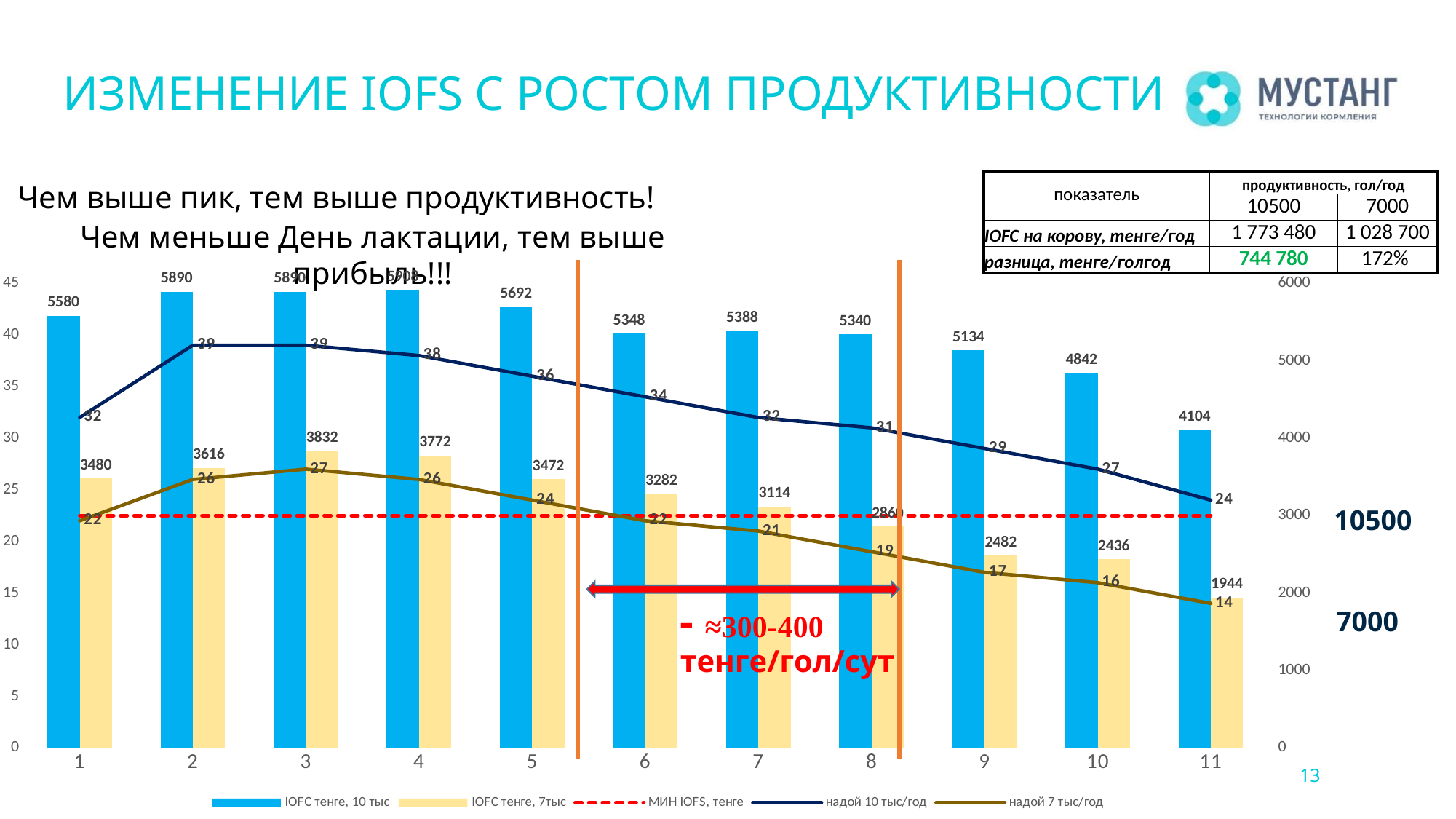
What is the difference between the надой 10 тыс/год and надой 7 тыс/год values at category 1? 10 What is the difference between the IOFC тенге, 10 тыс bar and the IOFC тенге, 7тыс bar at category 11? 2160 What is the value of the надой 7 тыс/год line at category 11? 14 Does the надой 7 тыс/год line rise or fall from category 3 to category 11? Falls What is the value of the IOFC тенге, 10 тыс bar for category 1? 5580 Which category has the lowest IOFC тенге, 10 тыс bar? 11 Which category has the highest IOFC тенге, 7тыс bar? 3 Which is larger, the IOFC тенге, 10 тыс bar at category 6 or at category 7? Category 7 How many series does the legend list? 5 What is the value of the IOFC тенге, 7тыс bar for category 3? 3832 What is the value of the надой 10 тыс/год line at category 2? 39 How many categories are shown on the x axis? 11